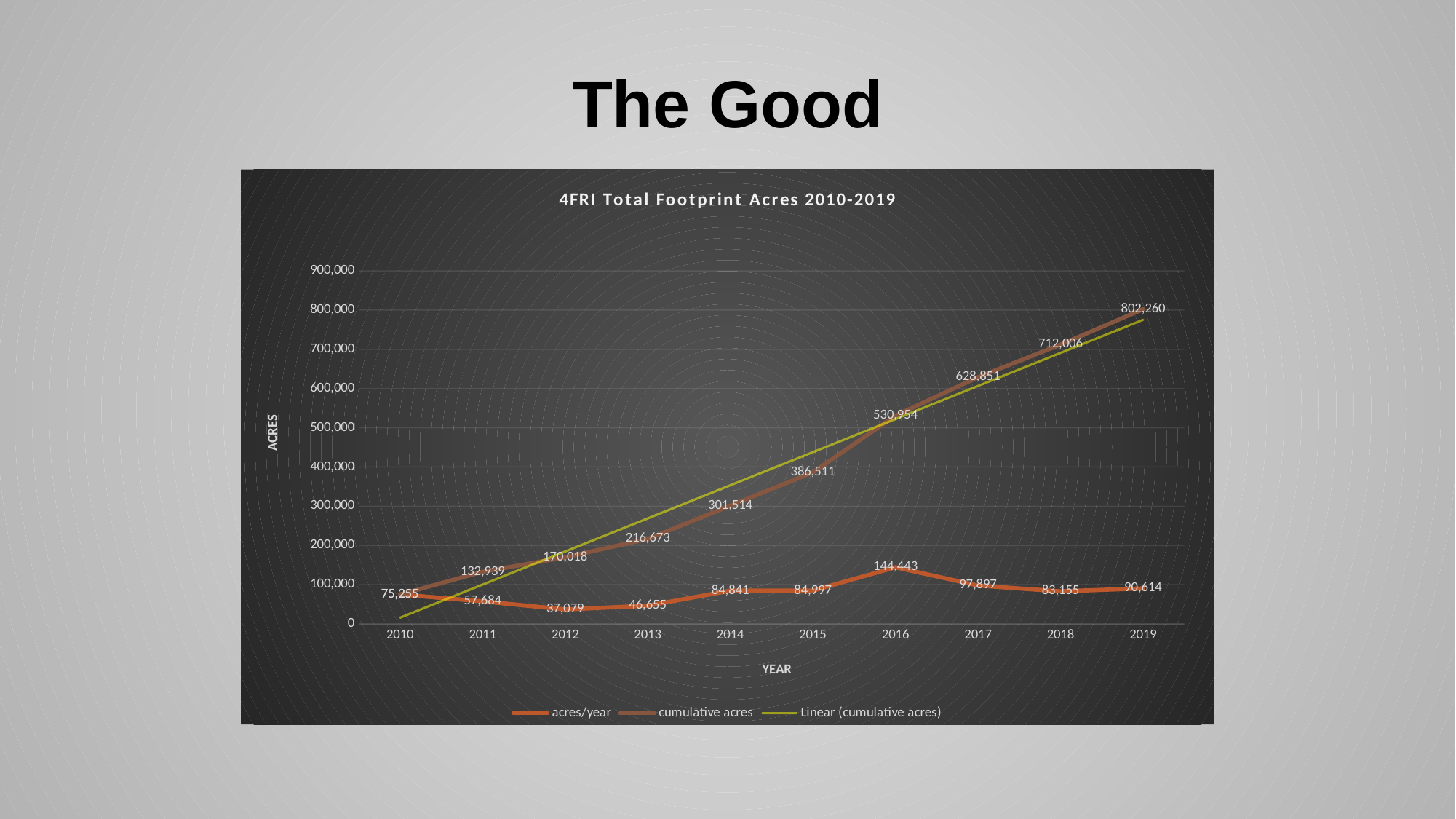
How many series does the legend list? 3 Which is larger, the acres/year value for 2017 or for 2018? 2017 What is the difference between the cumulative acres in 2019 and in 2018? 90,254 In which year is the acres/year value highest? 2016 What is the title of the chart? 4FRI Total Footprint Acres 2010-2019 What is the acres/year value for 2016? 144,443 What type of chart is shown on the slide? Line chart Does the cumulative acres series rise or fall from 2010 to 2019? Rise How many years are plotted along the x axis? 10 In which year is the acres/year value lowest? 2012 What is the cumulative acres value for 2019? 802,260 What is the acres/year value for 2012? 37,079